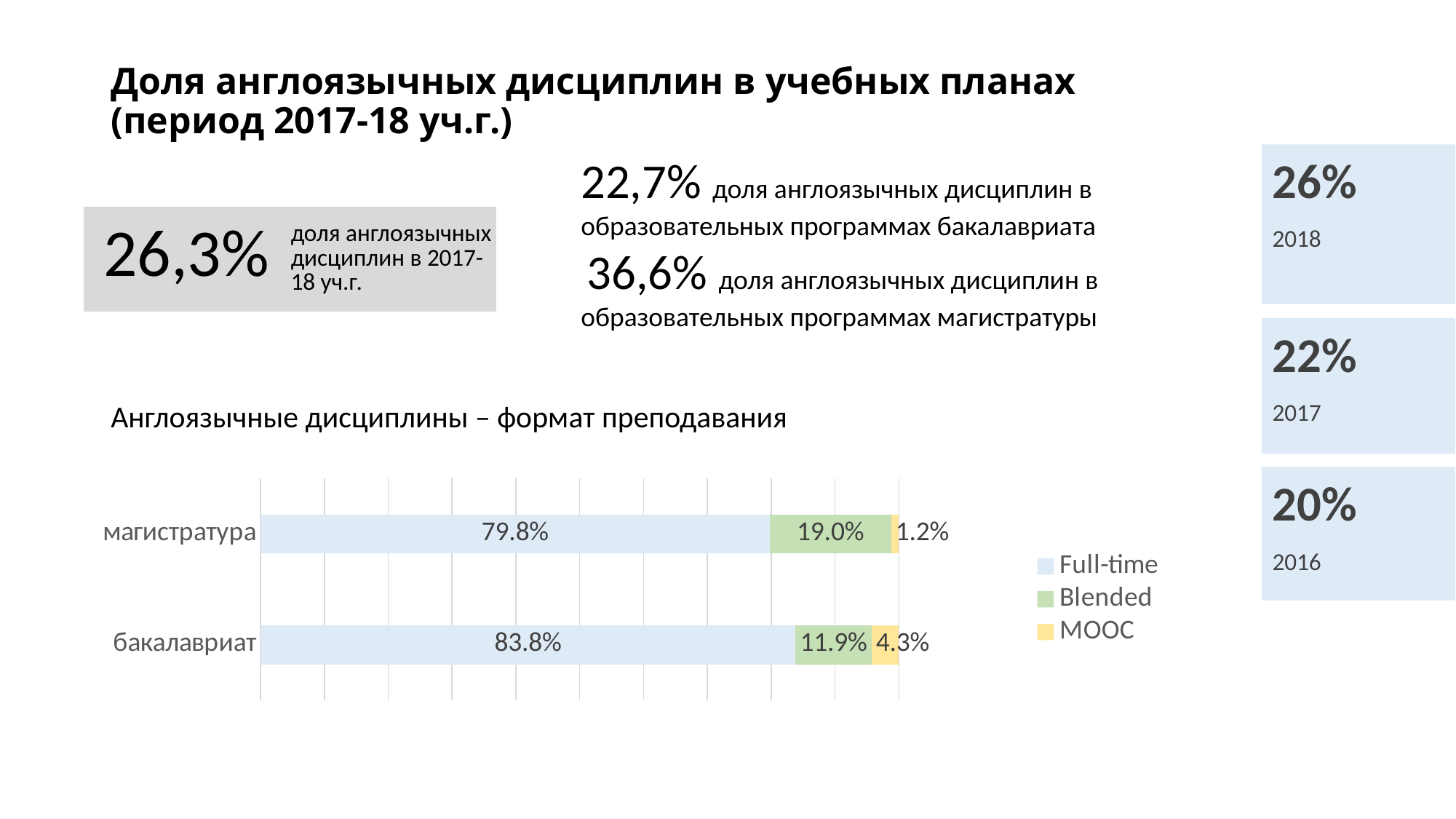
What kind of chart is shown on the slide? Stacked bar chart Which category has the higher Full-time value? бакалавриат What is the MOOC value for бакалавриат? 4.3% What is the difference between the Blended values for магистратура and бакалавриат? 7.1% Is the MOOC value larger for магистратура or for бакалавриат? бакалавриат How many series does the legend list? 3 What is the MOOC value for магистратура? 1.2% How many categories are shown on the chart? 2 What is the Blended value for бакалавриат? 11.9% What is the Full-time value for магистратура? 79.8% Which category has the lower Blended value? бакалавриат What is the title of the chart? Англоязычные дисциплины – формат преподавания